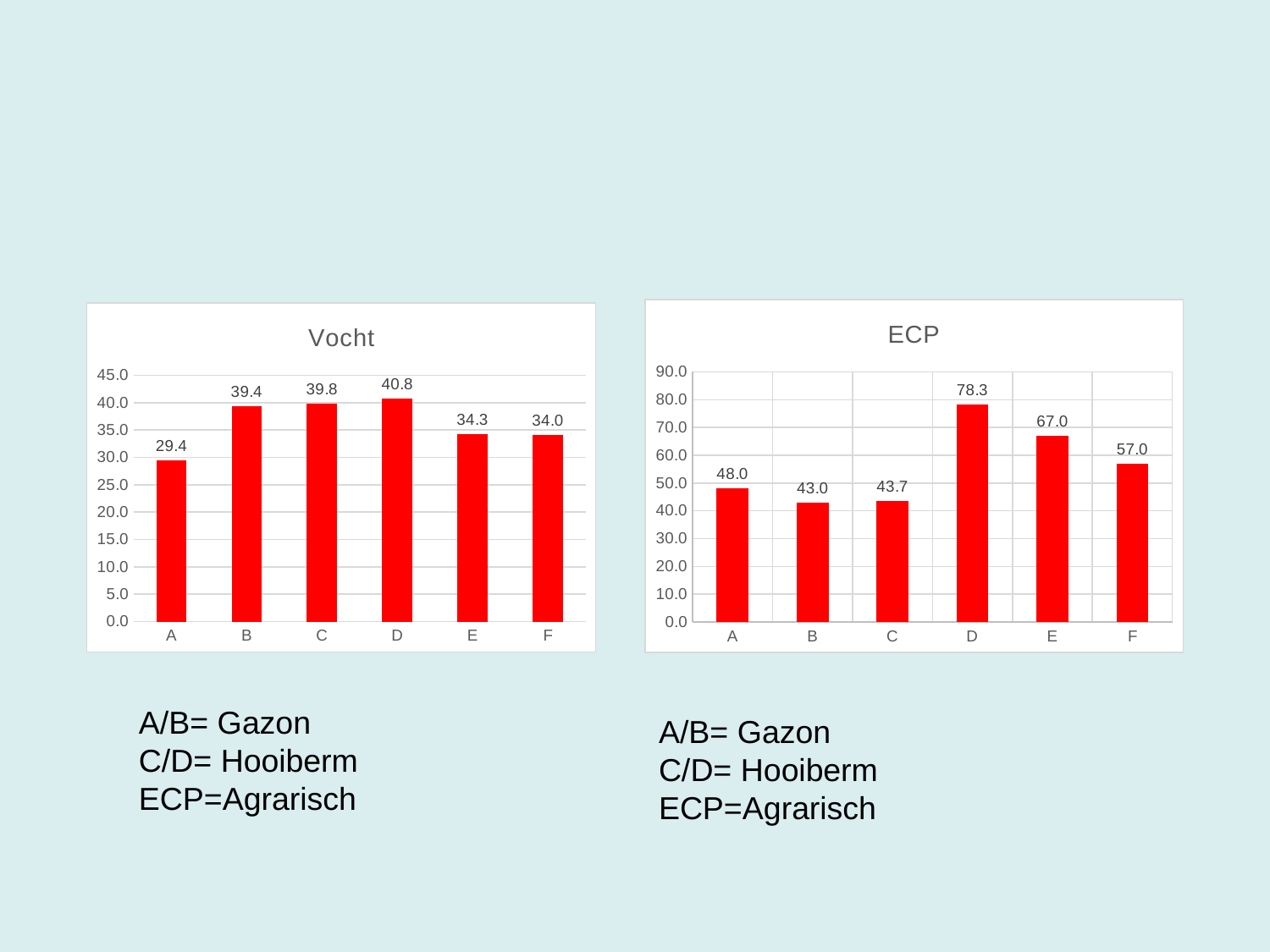
In the Vocht chart, which category has the lowest value? A In the Vocht chart, which category has the highest value? D In the ECP chart, what is the value for category D? 78.3 What is the title of the chart on the left side of the slide? Vocht In the ECP chart, which is larger, the value for E or the value for F? E In the ECP chart, what is the difference between the values for D and B? 35.3 In the ECP chart, which category has the lowest value? B In the Vocht chart, what is the value for category A? 29.4 What kind of chart is the ECP chart? bar chart In the Vocht chart, how many categories are shown on the x axis? 6 In the ECP chart, is the value for A greater or less than 50.0? less In the Vocht chart, what is the difference between the values for D and A? 11.4